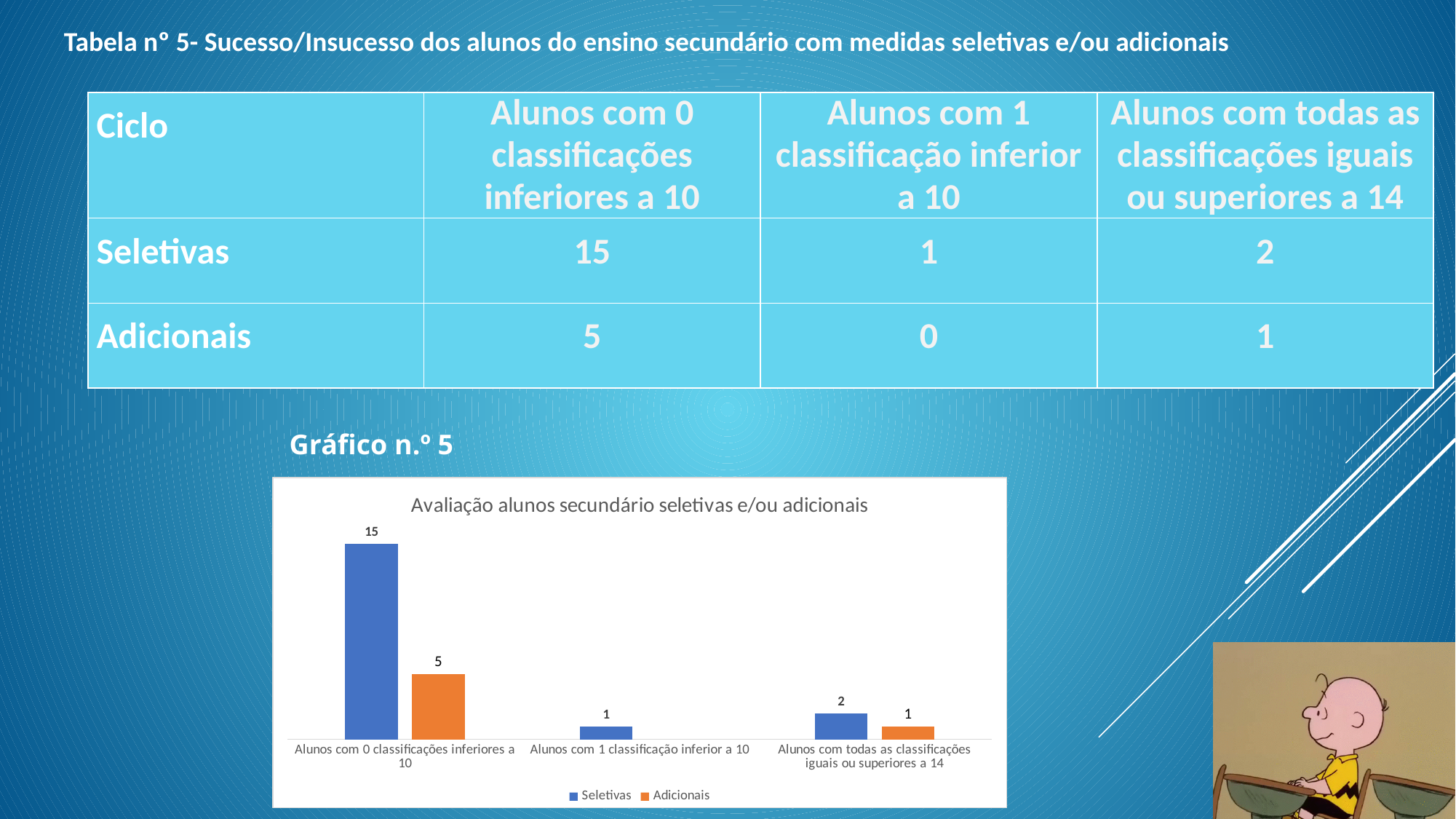
What is the difference between the Seletivas and Adicionais values for 'Alunos com 0 classificações inferiores a 10'? 10 Which category has the lowest Seletivas value? Alunos com 1 classificação inferior a 10 What is the title of the chart? Avaliação alunos secundário seletivas e/ou adicionais What type of chart is shown on the slide? Bar chart What is the value of the Seletivas series for 'Alunos com 1 classificação inferior a 10'? 1 For 'Alunos com todas as classificações iguais ou superiores a 14', which series has the larger value, Seletivas or Adicionais? Seletivas How many categories are shown on the x axis of the chart? 3 What is the value of the Adicionais series for 'Alunos com 0 classificações inferiores a 10'? 5 What is the value of the Seletivas series for 'Alunos com 0 classificações inferiores a 10'? 15 Which category has the highest Seletivas value? Alunos com 0 classificações inferiores a 10 How many series does the chart legend list? 2 What is the value of the Adicionais series for 'Alunos com todas as classificações iguais ou superiores a 14'? 1